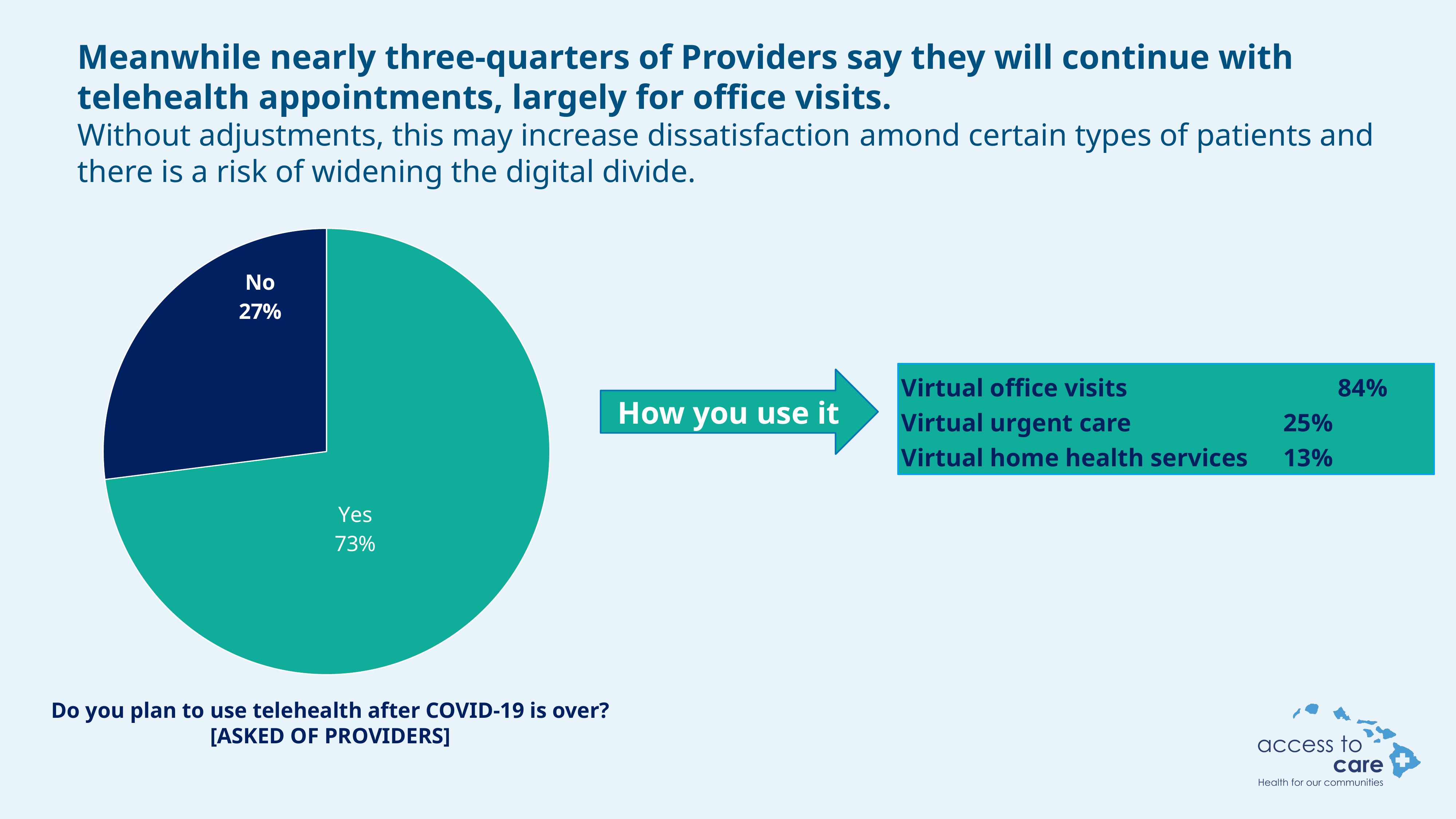
What kind of chart is shown on the slide? pie chart Which is larger, the Yes slice or the No slice? Yes What question is the pie chart based on, according to the caption below it? Do you plan to use telehealth after COVID-19 is over? What share of providers answered Yes to planning to use telehealth after COVID-19? 73% Is the Yes slice greater or less than 50% of the pie? greater What share of providers answered No to planning to use telehealth after COVID-19? 27% What is the difference in percentage points between the Yes and No slices? 46 Which slice of the pie chart is the smallest? No How many slices does the pie chart have? 2 Which slice of the pie chart is the largest? Yes What colour is the Yes slice of the pie chart? teal